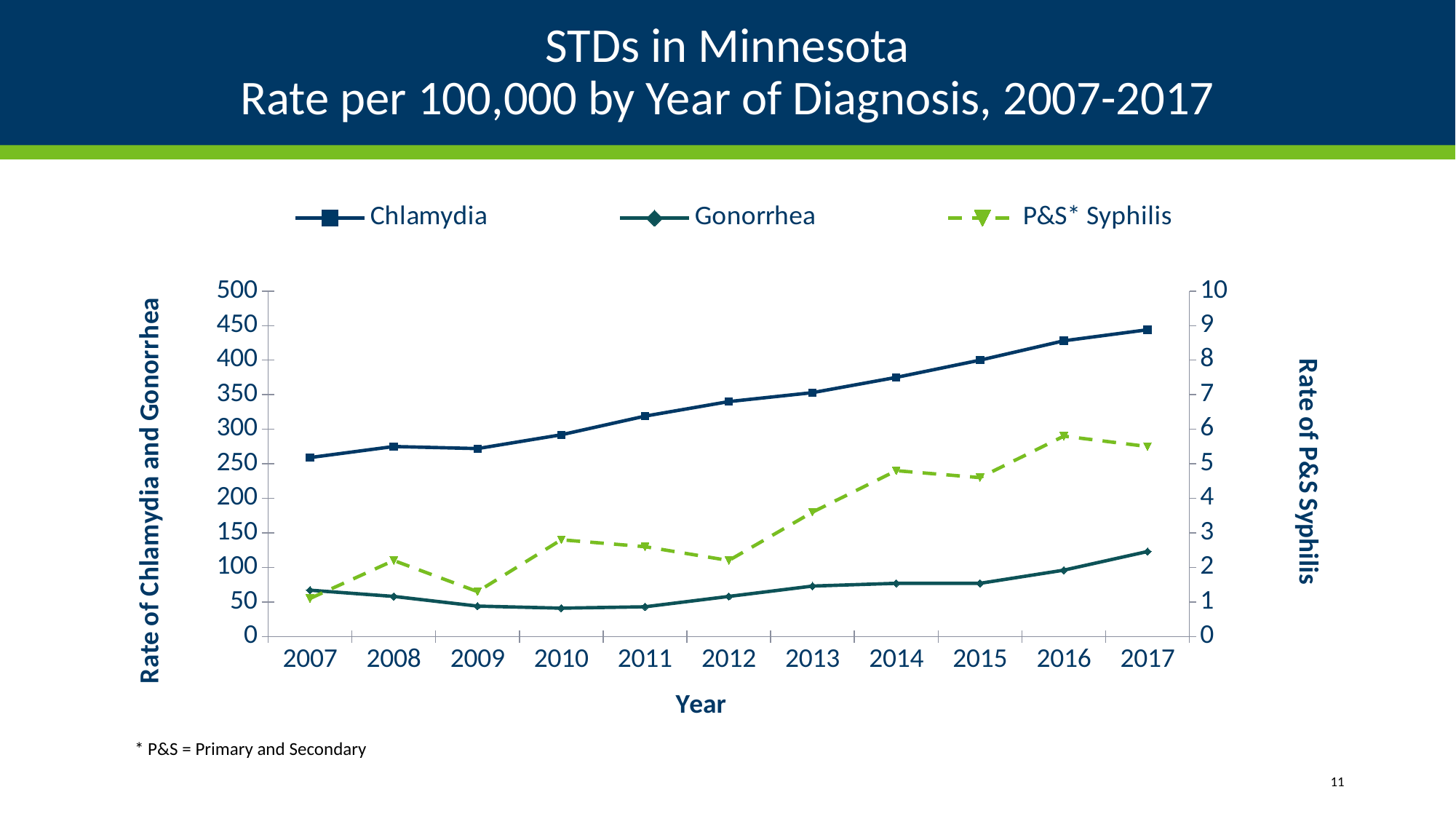
What kind of chart is shown on the slide? line chart How many series does the legend list? 3 Is the Gonorrhea rate for 2010 greater or less than 50? less Is the P&S Syphilis rate for 2016 greater or less than 5? greater Is the Chlamydia rate for 2017 greater or less than 400? greater Which is larger, the P&S Syphilis rate in 2012 or in 2013? 2013 In which year is the Gonorrhea rate highest? 2017 Does the Chlamydia rate generally rise or fall from 2007 to 2017? rise How many years are plotted along the x axis? 11 What is the title of the right-hand vertical axis? Rate of P&S Syphilis In which year is the Chlamydia rate highest? 2017 In which year is the Chlamydia rate lowest? 2007